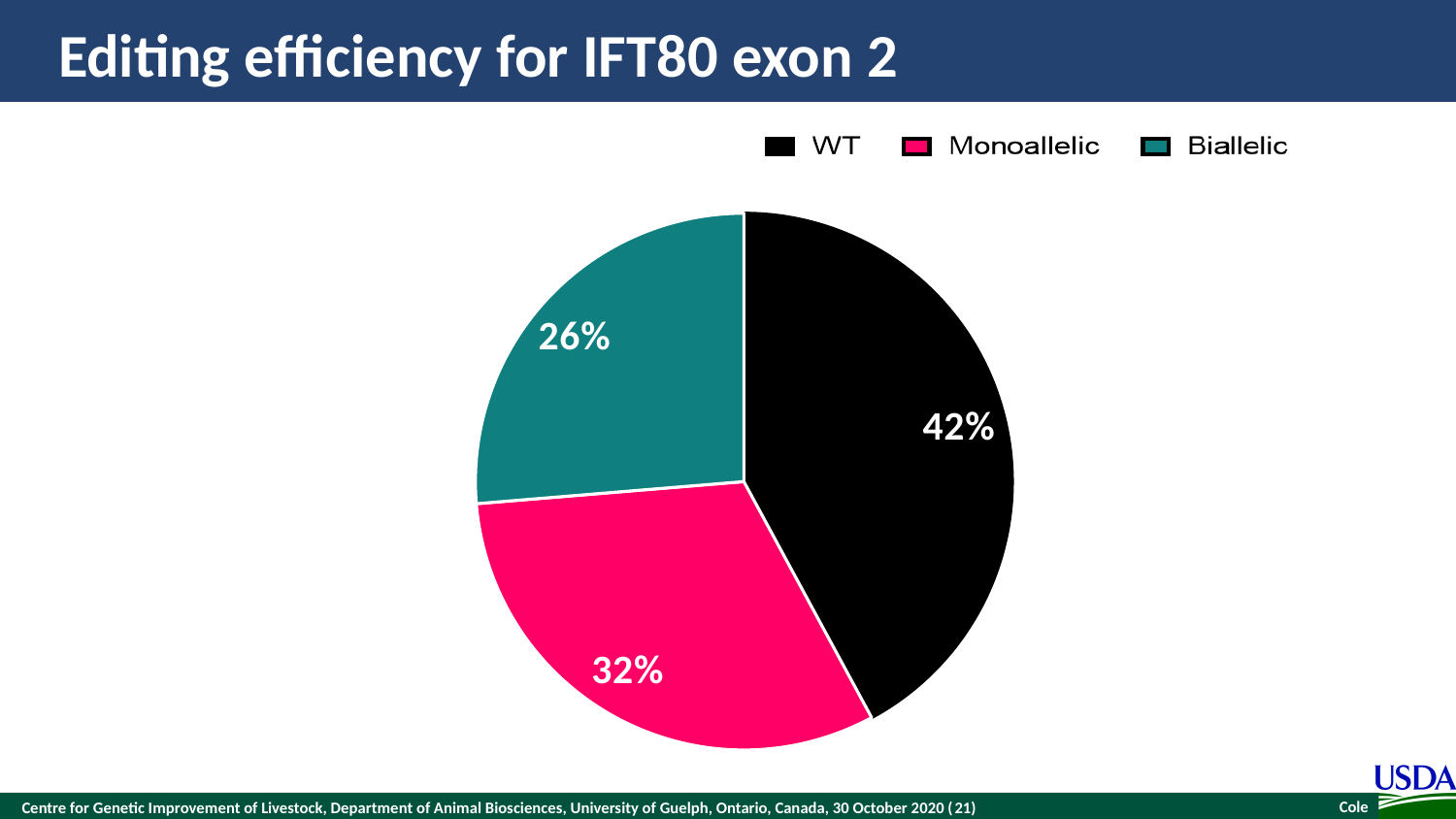
What is the difference in percentage points between the WT and Biallelic slices? 16 What share of the pie does the Biallelic slice represent? 26% What share of the pie does the Monoallelic slice represent? 32% What kind of chart is shown on the slide? pie chart How many entries does the legend list? 3 Which category has the smallest slice of the pie? Biallelic How many slices does the pie chart have? 3 Which is larger, the Monoallelic slice or the Biallelic slice? Monoallelic What colour is the Monoallelic slice? pink What share of the pie does the WT slice represent? 42% Which category has the largest slice of the pie? WT What is the difference in percentage points between the Monoallelic and Biallelic slices? 6